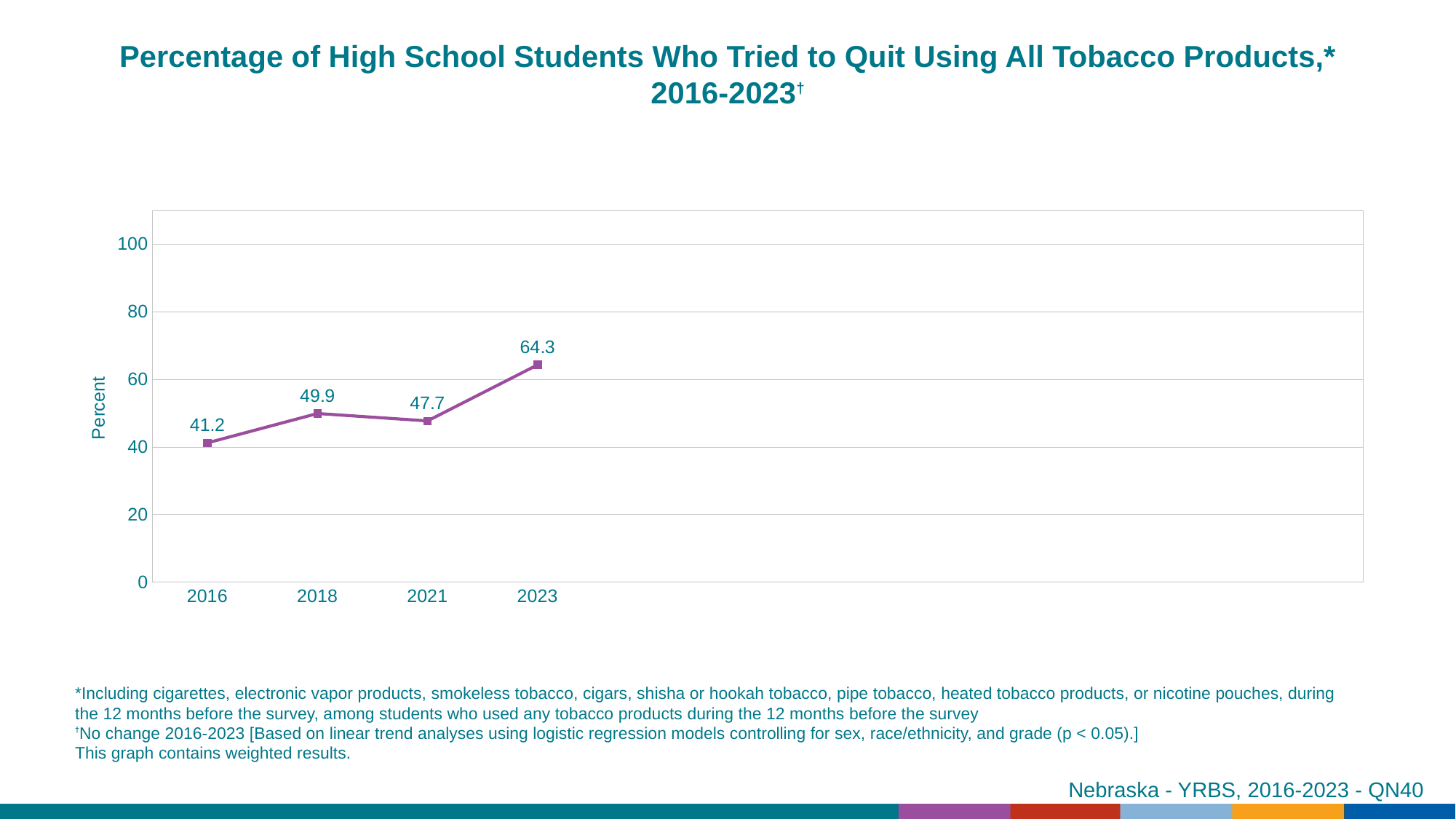
What is the value for 2023? 64.3 What is the value for 2018? 49.9 Which is larger, the value for 2018 or the value for 2021? 2018 Which year has the highest value? 2023 What is the value for 2016? 41.2 What is the label of the y axis? Percent How many years are plotted on the chart? 4 What is the difference between the values for 2023 and 2016? 23.1 Which year has the lowest value? 2016 What is the value for 2021? 47.7 Is the value for 2023 greater or less than 60? greater What kind of chart is shown on the slide? line chart